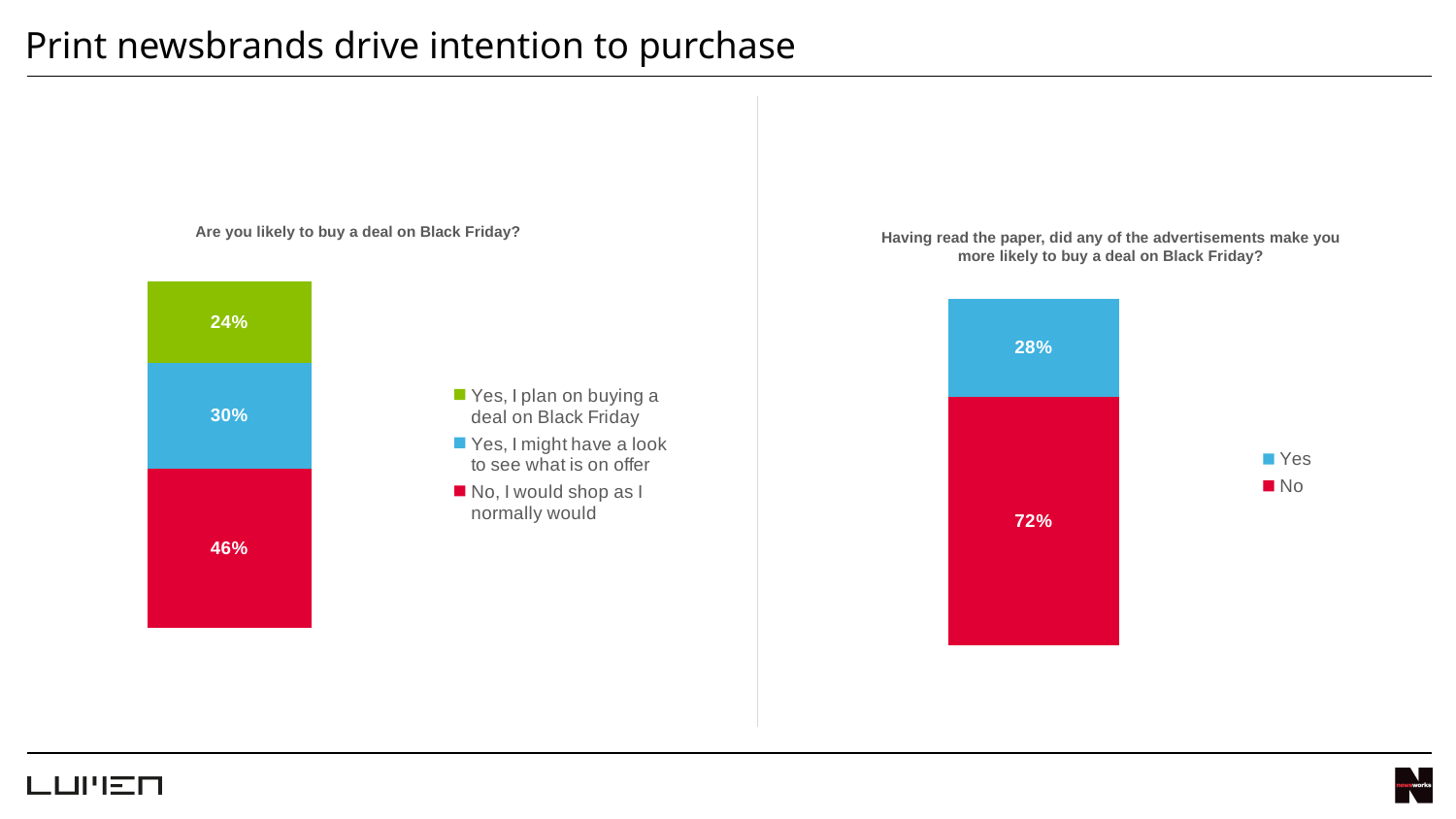
In the chart titled 'Are you likely to buy a deal on Black Friday?', what percentage answered 'Yes, I might have a look to see what is on offer'? 30% In the chart titled 'Are you likely to buy a deal on Black Friday?', which response has the smallest share? Yes, I plan on buying a deal on Black Friday In the chart on the right, 'Having read the paper, did any of the advertisements make you more likely to buy a deal on Black Friday?', what percentage answered 'Yes'? 28% In the chart titled 'Are you likely to buy a deal on Black Friday?', which response has the largest share? No, I would shop as I normally would In the chart on the right, 'Having read the paper, did any of the advertisements make you more likely to buy a deal on Black Friday?', what percentage answered 'No'? 72% In the chart titled 'Are you likely to buy a deal on Black Friday?', what is the difference between the 'No, I would shop as I normally would' share and the 'Yes, I plan on buying a deal on Black Friday' share? 22% In the chart titled 'Are you likely to buy a deal on Black Friday?', what percentage answered 'No, I would shop as I normally would'? 46% In the chart titled 'Are you likely to buy a deal on Black Friday?', how many series does the legend list? 3 In the chart on the right, 'Having read the paper, did any of the advertisements make you more likely to buy a deal on Black Friday?', what is the total of the stacked bar? 100% In the chart on the right, 'Having read the paper, did any of the advertisements make you more likely to buy a deal on Black Friday?', what is the difference between the 'No' and 'Yes' shares? 44% What kind of chart is used on the right side of the slide? Stacked bar chart In the chart titled 'Are you likely to buy a deal on Black Friday?', what percentage answered 'Yes, I plan on buying a deal on Black Friday'? 24%